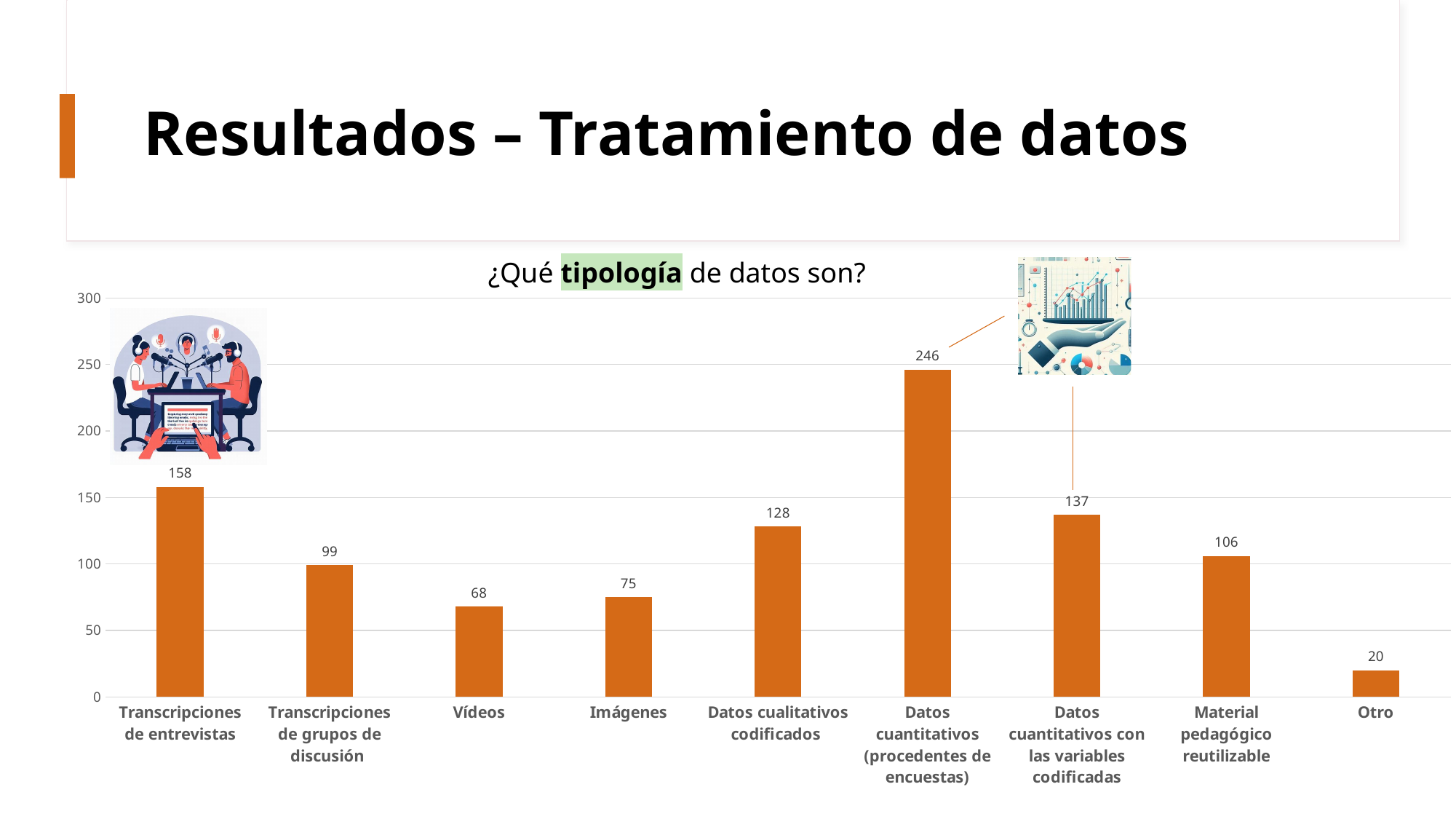
Which is larger, the value for Imágenes or the value for Vídeos? Imágenes How many categories are shown on the x axis? 9 Is the value for Datos cualitativos codificados greater or less than 100? greater What is the value for Transcripciones de entrevistas? 158 Which category has the highest value? Datos cuantitativos (procedentes de encuestas) What is the difference between the values for Transcripciones de grupos de discusión and Vídeos? 31 What is the value for Material pedagógico reutilizable? 106 What is the value for Datos cuantitativos con las variables codificadas? 137 What is the title of the chart? ¿Qué tipología de datos son? What kind of chart is shown on the slide? bar chart What is the difference between the values for Datos cuantitativos (procedentes de encuestas) and Datos cualitativos codificados? 118 Which category has the lowest value? Otro